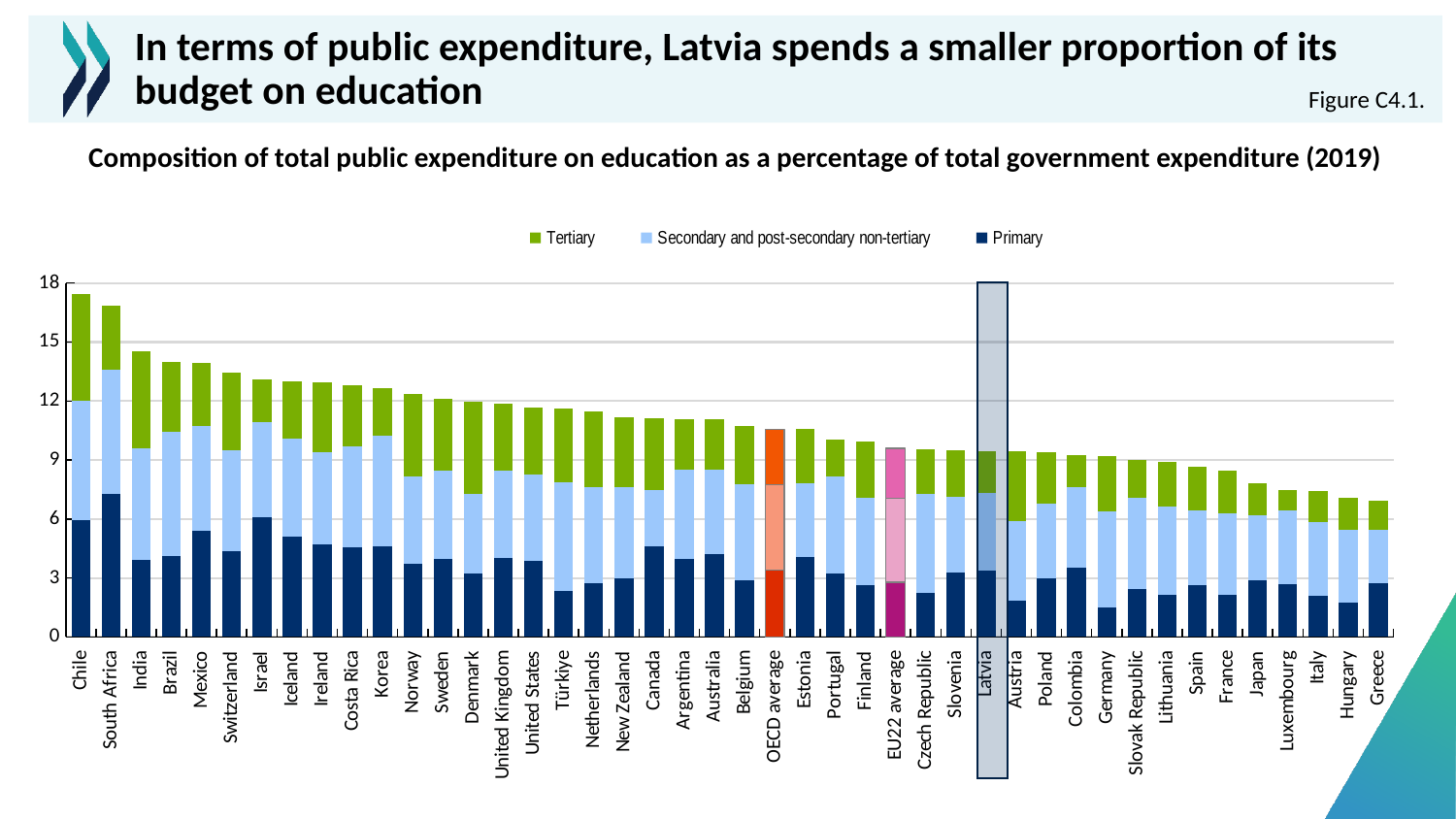
Is the Primary value for South Africa greater or less than 6? greater Is the total value for Latvia greater or less than 12? less How many series does the legend list? 3 Is the total value for Greece greater or less than 9? less Which has a larger total value, Chile or India? Chile Which country has the highest total public expenditure on education as a percentage of total government expenditure? Chile Which country has the lowest total public expenditure on education as a percentage of total government expenditure? Greece What kind of chart is shown on the slide? Stacked bar chart Which series is shown in green in the legend? Tertiary How many countries or averages are shown along the x axis? 44 Do the total values rise or fall moving from left to right along the x axis? Fall